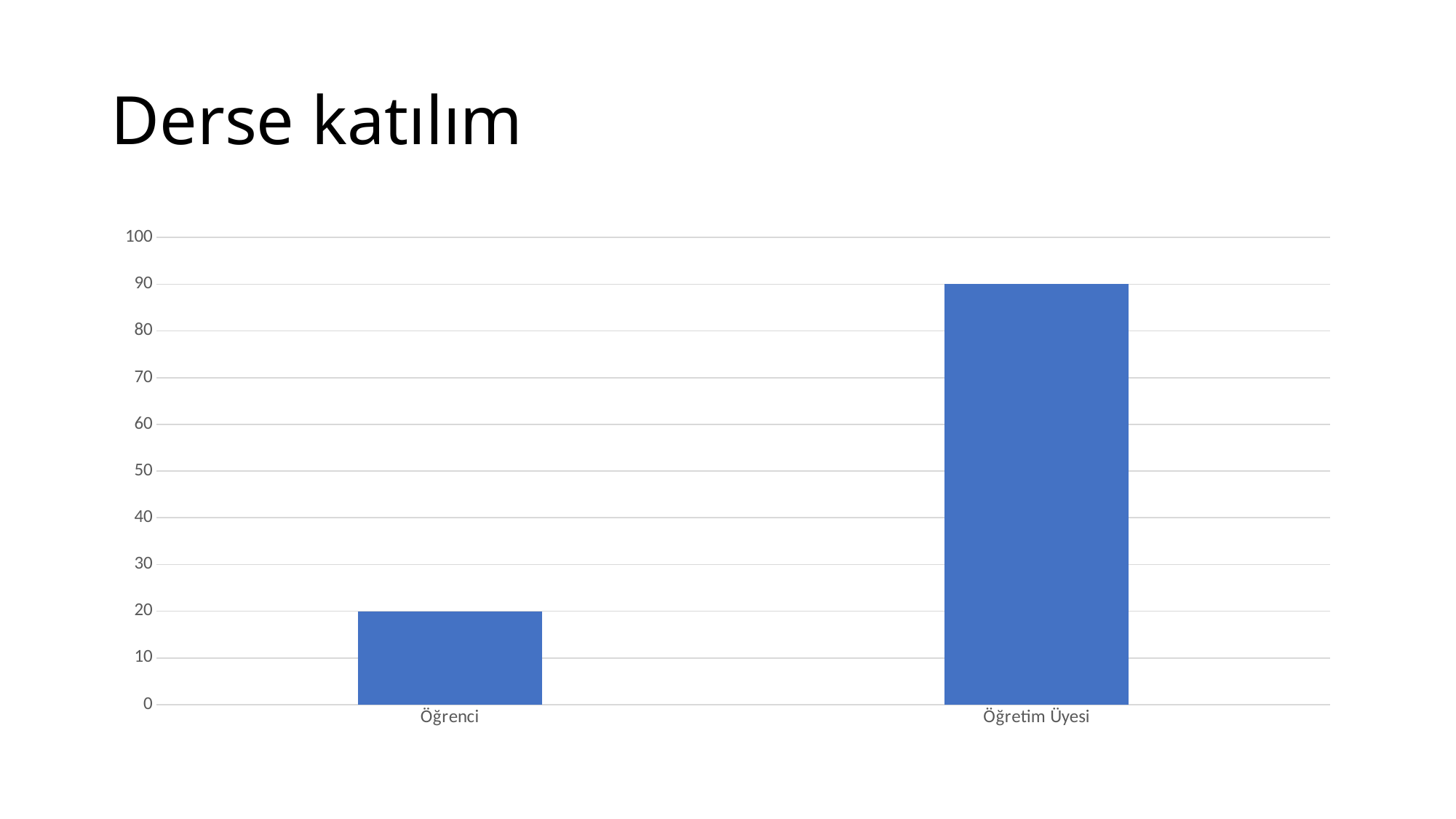
Is the value for Öğrenci greater or less than 30? less Which is larger, the value for Öğrenci or the value for Öğretim Üyesi? Öğretim Üyesi What kind of chart is shown on the slide? bar chart What is the value for Öğretim Üyesi? 90 Is the value for Öğretim Üyesi greater or less than 50? greater Which category has the highest value? Öğretim Üyesi Which category has the lowest value? Öğrenci What is the title of the slide? Derse katılım What is the value for Öğrenci? 20 What is the difference between the values for Öğretim Üyesi and Öğrenci? 70 What is the maximum value shown on the vertical axis? 100 How many categories are shown on the x axis? 2